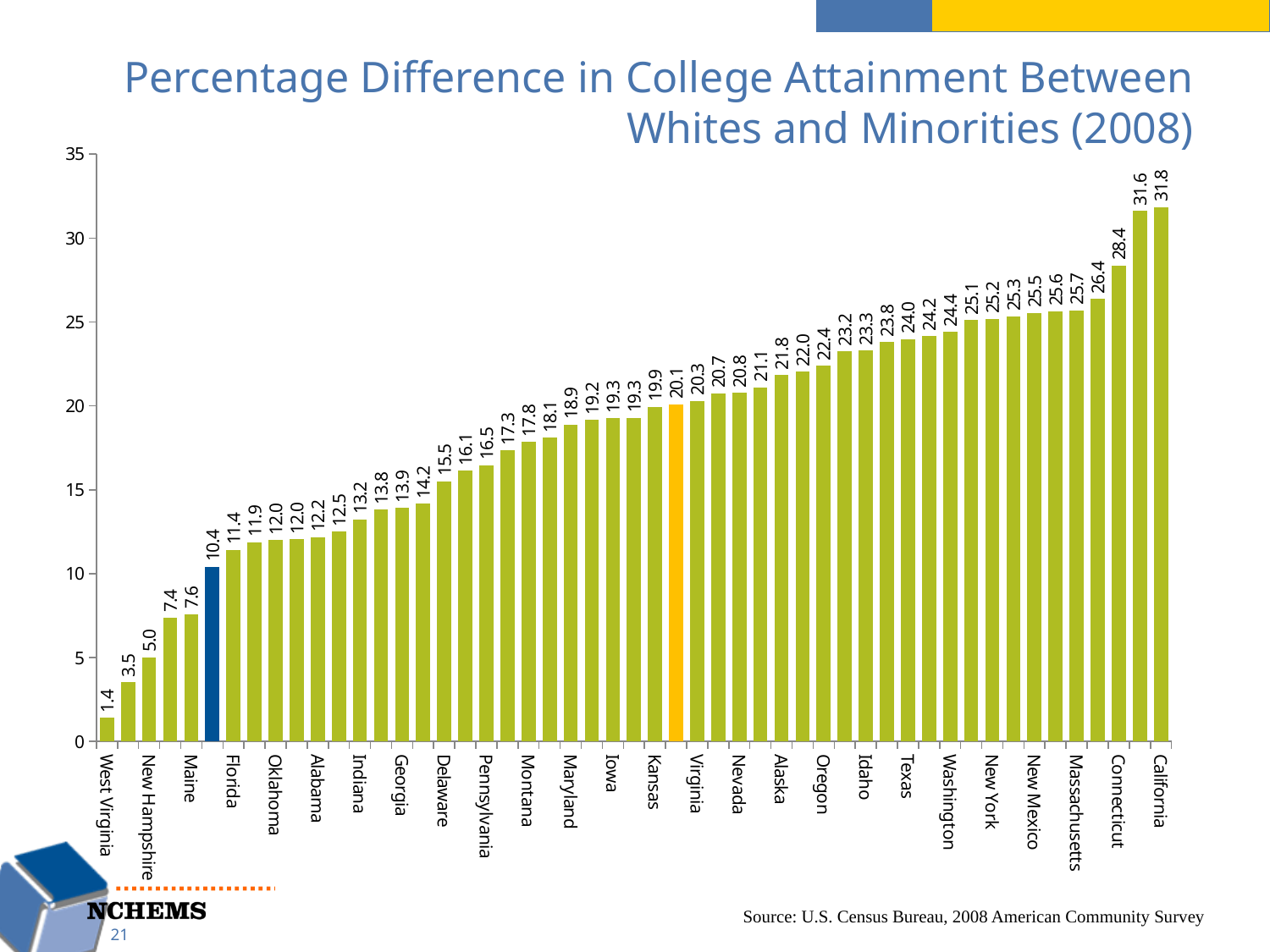
Which has a larger value, Texas or Florida? Texas Which state has the lowest value? West Virginia What is the value for California? 31.8 What is the value for Texas? 24.0 Is the value for Massachusetts greater or less than 25? greater What is the title of the chart? Percentage Difference in College Attainment Between Whites and Minorities (2008) What is the value for West Virginia? 1.4 Which state has the highest value? California What kind of chart is shown? Bar chart Do the values rise or fall from left to right along the x axis? Rise What is the difference between the values for California and West Virginia? 30.4 What is the value for Connecticut? 28.4